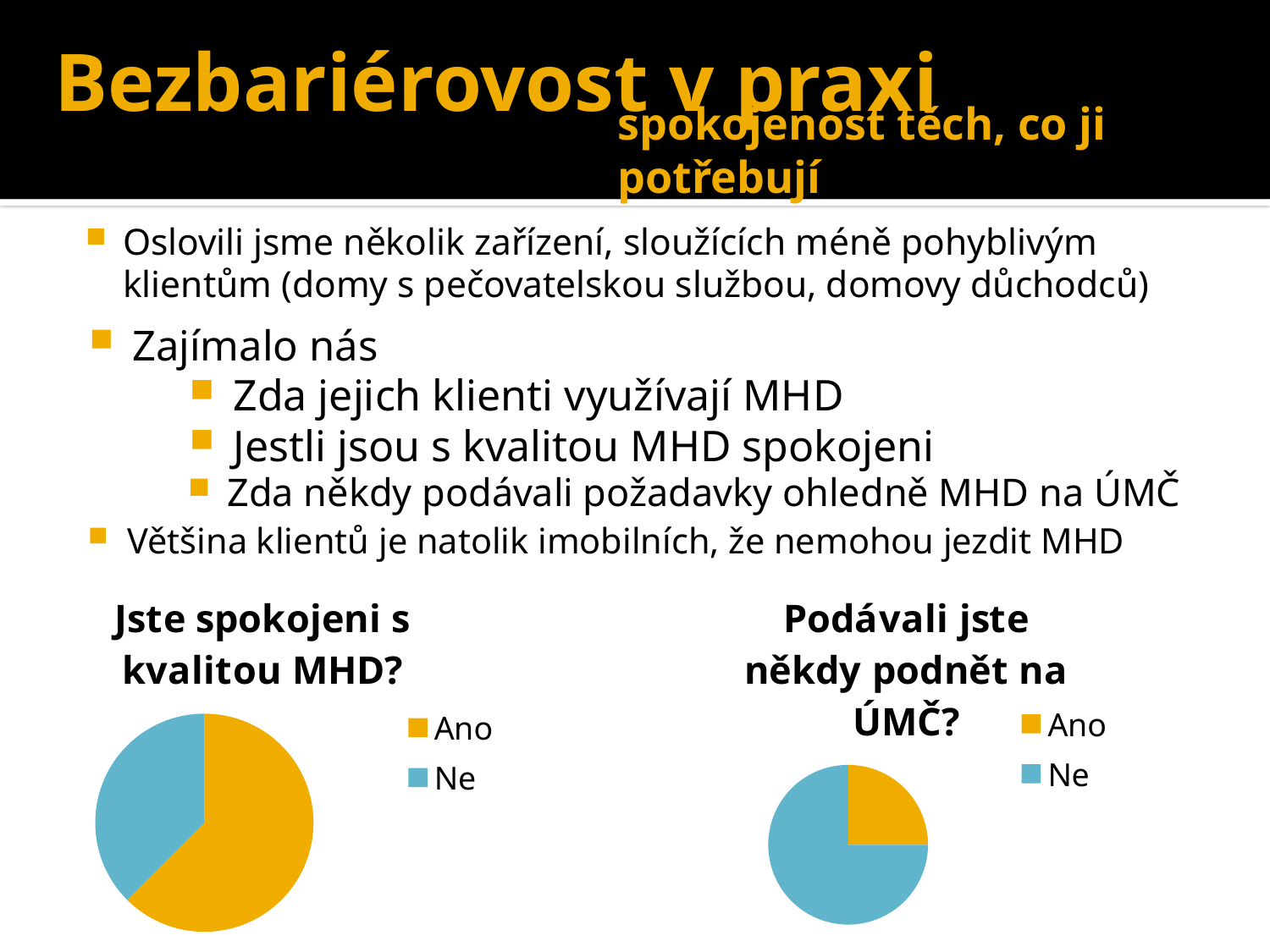
In the chart "Podávali jste někdy podnět na ÚMČ?", is the Ano slice larger or smaller than the Ne slice? smaller In the chart "Podávali jste někdy podnět na ÚMČ?", what colour is the Ne slice? blue In the chart "Jste spokojeni s kvalitou MHD?", which slice is the largest? Ano In the chart "Jste spokojeni s kvalitou MHD?", which slice is the smallest? Ne In the chart "Jste spokojeni s kvalitou MHD?", is the Ano slice larger or smaller than the Ne slice? larger How many entries does the legend of the chart "Podávali jste někdy podnět na ÚMČ?" list? 2 What kind of chart is the chart titled "Jste spokojeni s kvalitou MHD?"? pie chart What kind of chart is the chart titled "Podávali jste někdy podnět na ÚMČ?"? pie chart How many slices does the pie chart on the left of the slide have? 2 In the chart "Podávali jste někdy podnět na ÚMČ?", which slice is the smallest? Ano In the chart "Podávali jste někdy podnět na ÚMČ?", which slice is the largest? Ne How many entries does the legend of the chart "Jste spokojeni s kvalitou MHD?" list? 2